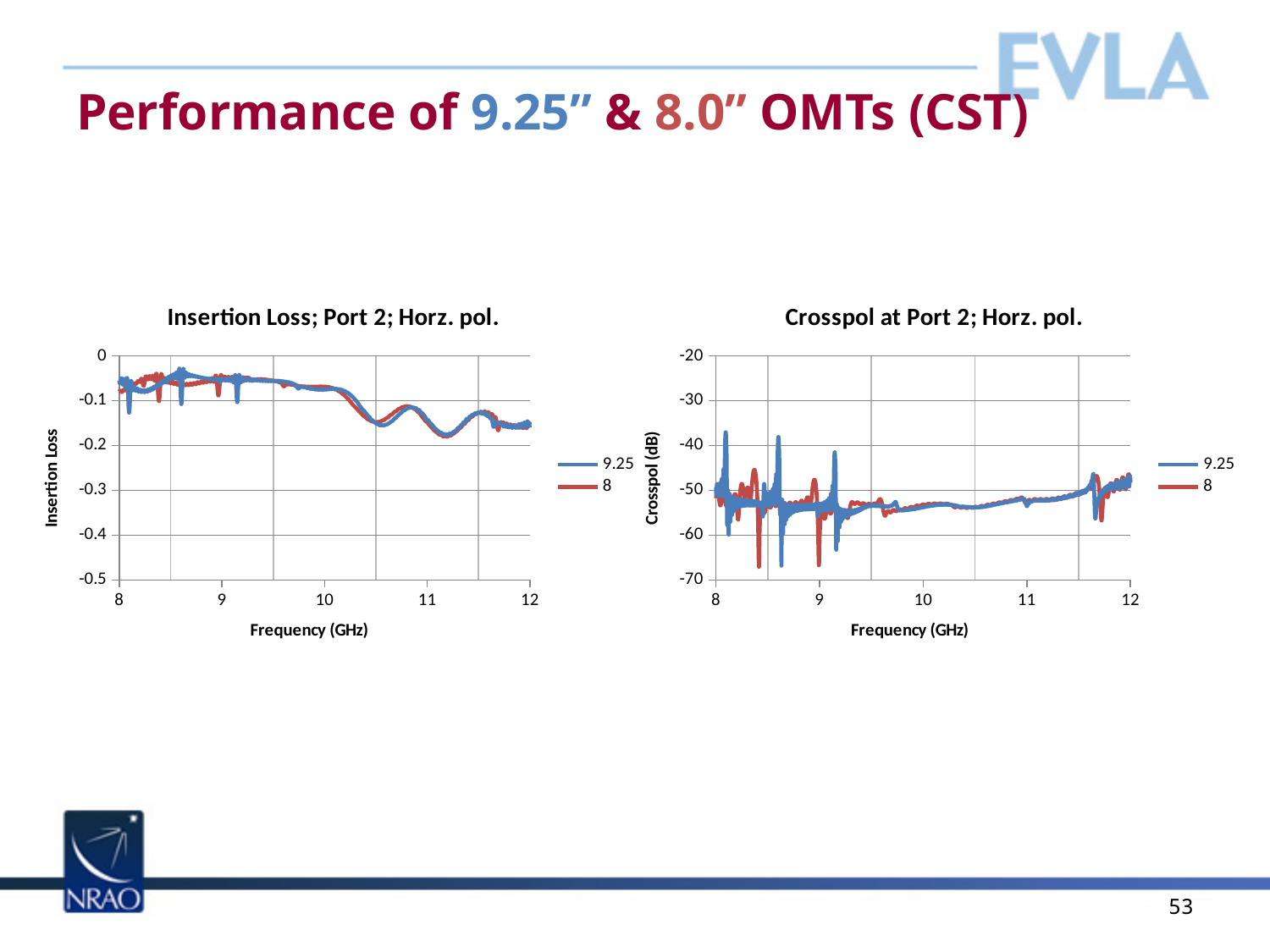
What kind of chart is the 'Insertion Loss; Port 2; Horz. pol.' chart? line chart In the 'Insertion Loss; Port 2; Horz. pol.' chart, is the value of the 9.25 series at 11 GHz greater or less than -0.3? greater In the 'Crosspol at Port 2; Horz. pol.' chart, is the value of the 9.25 series at 10 GHz greater or less than -50? less In the 'Crosspol at Port 2; Horz. pol.' chart, what is the label of the y axis? Crosspol (dB) In the 'Crosspol at Port 2; Horz. pol.' chart, is the value of the 8 series at 10.5 GHz greater or less than -60? greater How many series does the legend of the 'Crosspol at Port 2; Horz. pol.' chart list? 2 How many series does the legend of the 'Insertion Loss; Port 2; Horz. pol.' chart list? 2 In the 'Insertion Loss; Port 2; Horz. pol.' chart, do the insertion loss values generally rise or fall as frequency increases from 8 to 12 GHz? fall What kind of chart is the 'Crosspol at Port 2; Horz. pol.' chart? line chart In the 'Insertion Loss; Port 2; Horz. pol.' chart, what are the two series named in the legend? 9.25 and 8